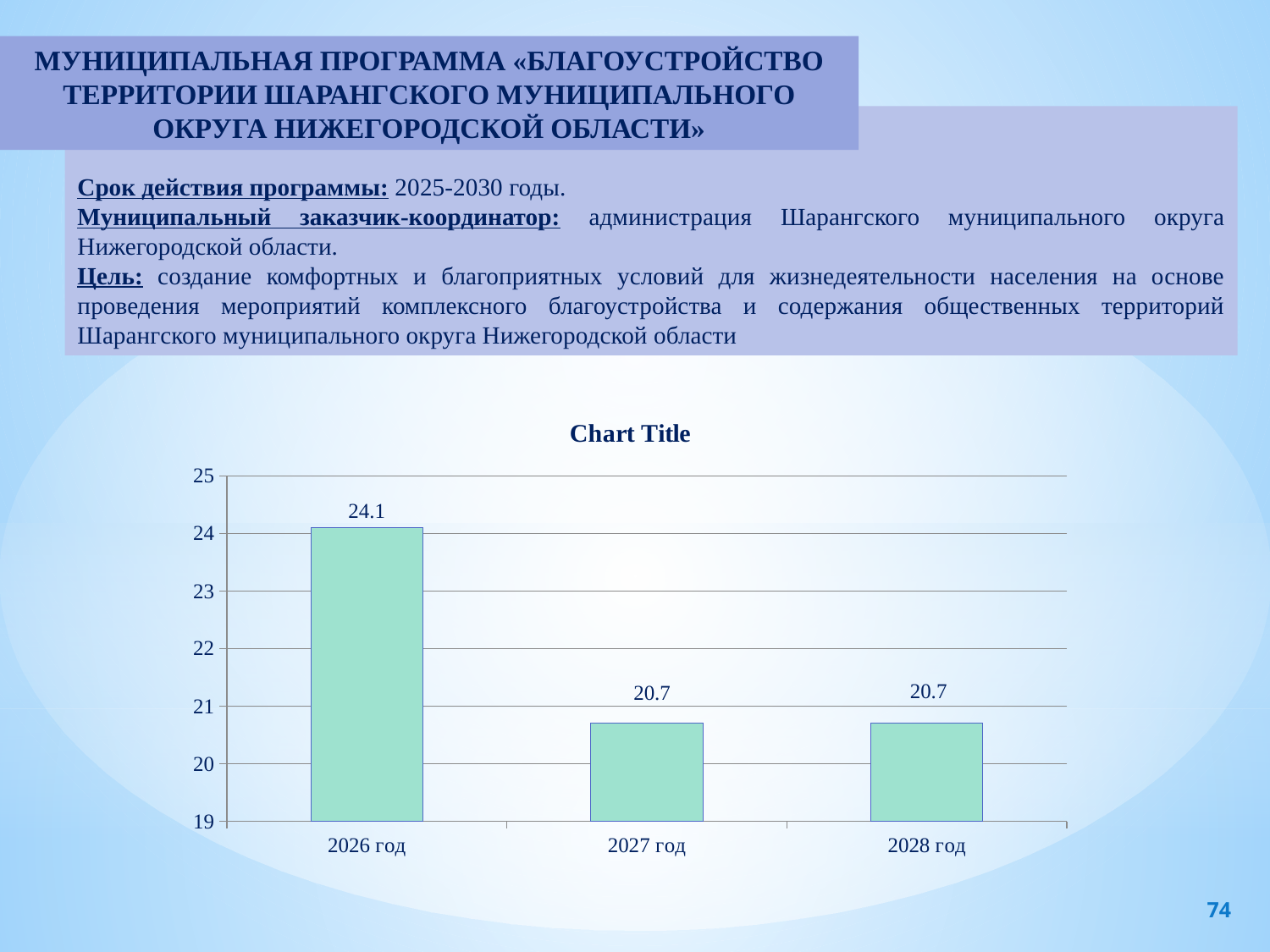
What is the value for 2026 год? 24.1 Which year has the highest value? 2026 год Which is larger, the value for 2026 год or the value for 2028 год? 2026 год What is the value for 2027 год? 20.7 What is the title of the chart? Chart Title What kind of chart is shown on the slide? bar chart What is the value for 2028 год? 20.7 Is the value for 2027 год greater or less than 22? less What is the difference between the values for 2026 год and 2027 год? 3.4 Do the values rise or fall from 2026 год to 2027 год? fall Is the value for 2026 год greater or less than 23? greater How many categories are shown on the x axis? 3